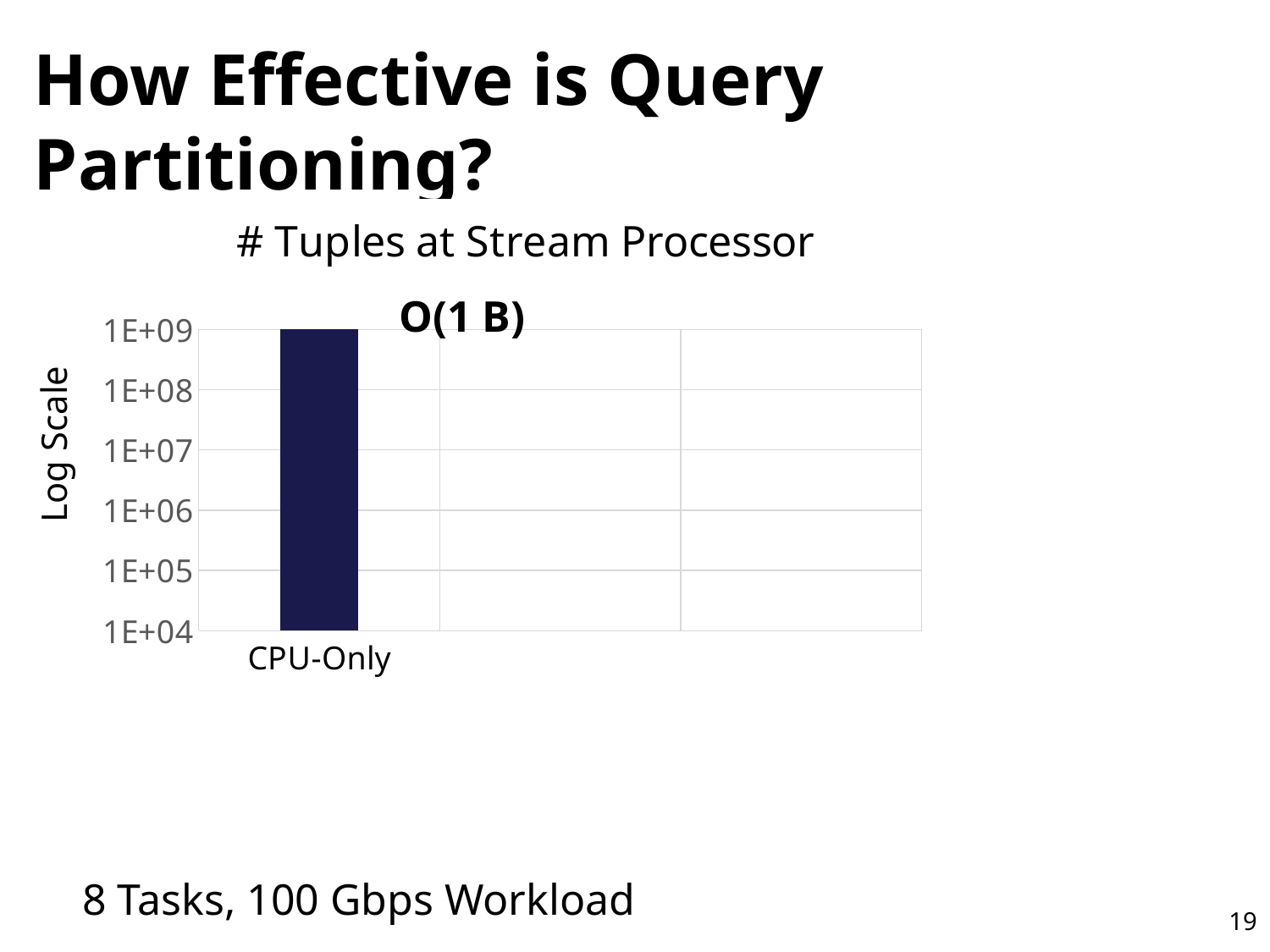
What is the highest tick shown on the vertical axis? 1E+09 What is the lowest tick shown on the vertical axis? 1E+04 How many labeled categories are plotted in the chart? 1 Which axis tick does the CPU-Only bar reach? 1E+09 What kind of chart is shown on the slide? bar chart What is the label on the vertical axis of the chart? Log Scale Is the value for CPU-Only greater or less than 1E+06? greater Is the value for CPU-Only greater or less than 1E+08? greater What is the title of the chart? # Tuples at Stream Processor What annotation is printed above the CPU-Only bar? O(1 B) Which category is plotted in the chart? CPU-Only